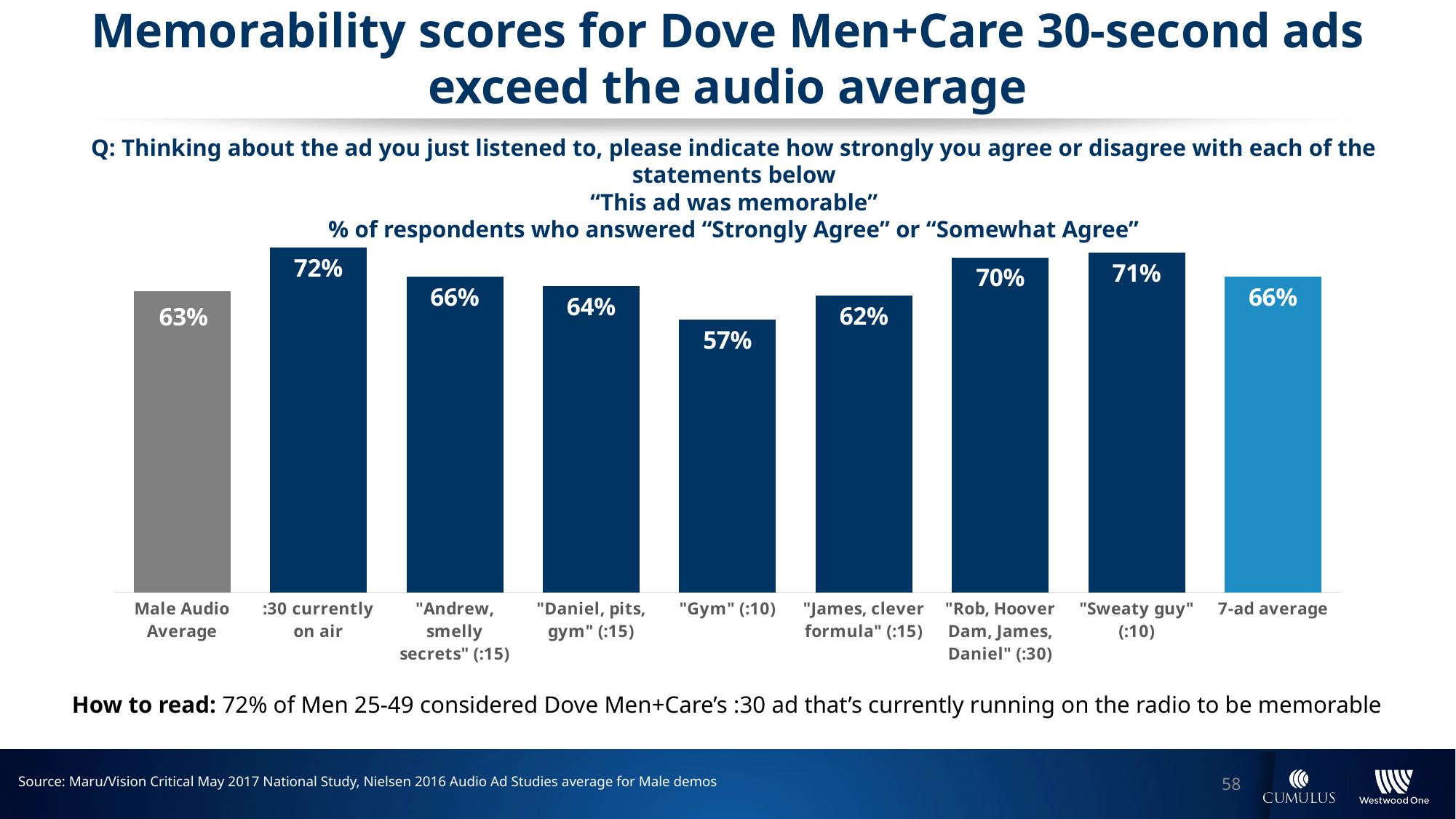
Which is larger, the value for "Rob, Hoover Dam, James, Daniel" (:30) or the value for "James, clever formula" (:15)? "Rob, Hoover Dam, James, Daniel" (:30) What is the difference between the ":30 currently on air" score and the Male Audio Average? 9% Which bar is shown in grey? Male Audio Average What is the value for the "Sweaty guy" (:10) ad? 71% What is the value for the ":30 currently on air" ad? 72% What kind of chart is shown on the slide? Bar chart What is the difference between the 7-ad average and the Male Audio Average? 3% Which category has the lowest memorability score? "Gym" (:10) What is the value for the "Gym" (:10) ad? 57% How many bars are shown in the chart? 9 What is the memorability score for the Male Audio Average? 63% Which category has the highest memorability score? :30 currently on air